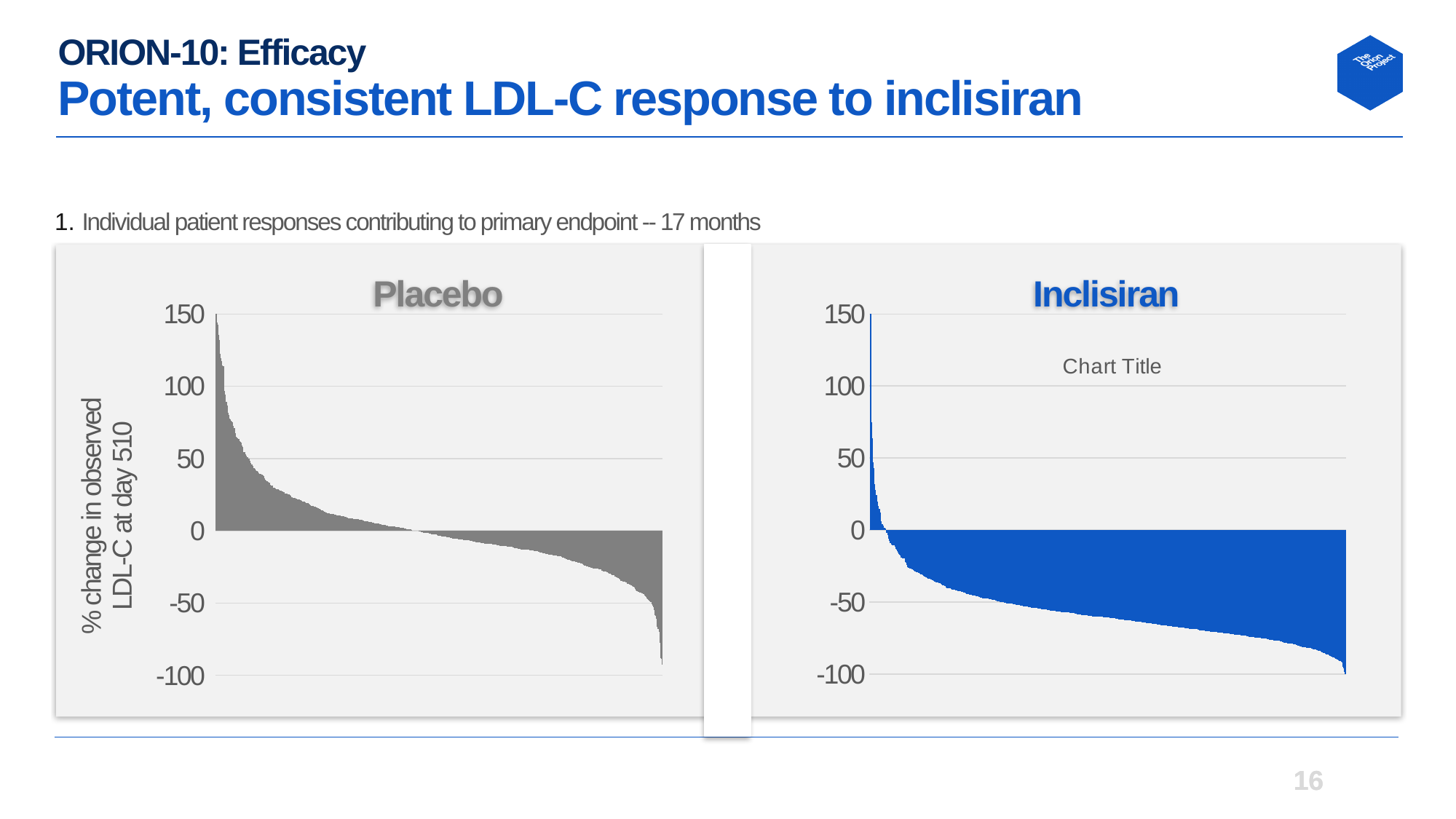
In the Inclisiran chart, is the value of the rightmost bar greater or less than -50? less What is the y-axis label of the Placebo chart? % change in observed LDL-C at day 510 In the Placebo chart, do the values rise or fall from left to right? fall What colour are the bars in the Inclisiran chart? blue How many charts are shown on the slide? 2 In the Inclisiran chart, do the values rise or fall from left to right? fall In the Placebo chart, is the value of the rightmost bar greater or less than -50? less Which chart, Placebo or Inclisiran, has a larger proportion of bars below 0? Inclisiran In the Placebo chart, is the value of the leftmost bar greater or less than 100? greater What kind of chart is the Placebo chart? bar chart